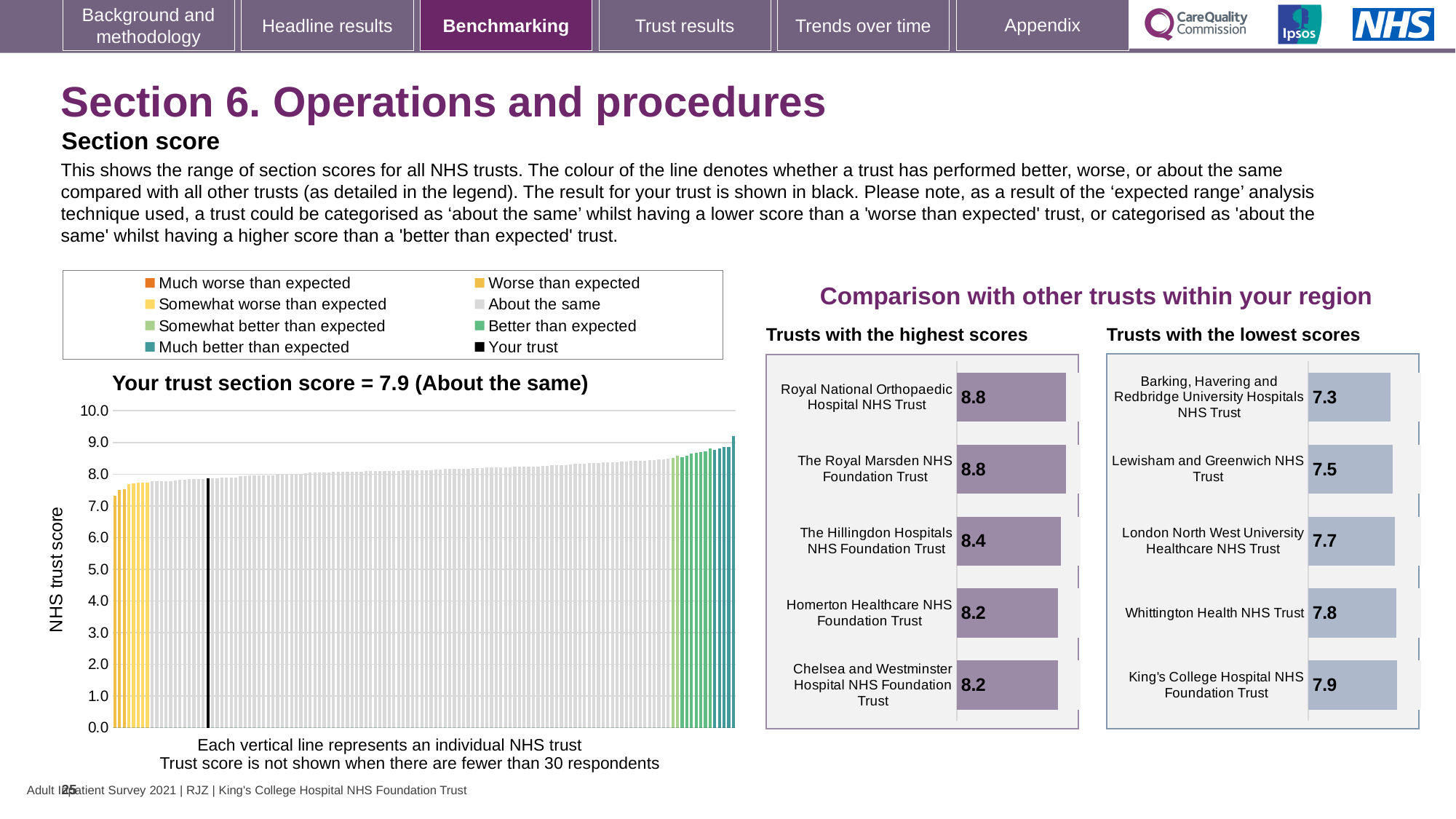
In the 'Trusts with the highest scores' chart, what is the score for The Hillingdon Hospitals NHS Foundation Trust? 8.4 Which is larger: the score for The Hillingdon Hospitals NHS Foundation Trust in the 'Trusts with the highest scores' chart or the score for Lewisham and Greenwich NHS Trust in the 'Trusts with the lowest scores' chart? The Hillingdon Hospitals NHS Foundation Trust In the 'Trusts with the lowest scores' chart, which trust has the lowest score? Barking, Havering and Redbridge University Hospitals NHS Trust In the 'Your trust section score' chart, is the value of the lowest bar greater or less than 8.0? less In the 'Trusts with the highest scores' chart, what is the score for Homerton Healthcare NHS Foundation Trust? 8.2 In the 'Trusts with the lowest scores' chart, which trust has the highest score? King's College Hospital NHS Foundation Trust In the 'Trusts with the highest scores' chart, what is the difference between the score for Royal National Orthopaedic Hospital NHS Trust and the score for Chelsea and Westminster Hospital NHS Foundation Trust? 0.6 How many trusts are shown in the 'Trusts with the highest scores' chart? 5 What is the y-axis label of the 'Your trust section score' chart? NHS trust score How many entries does the legend above the 'Your trust section score' chart list? 8 In the chart 'Your trust section score', what is the section score for your trust? 7.9 What kind of chart is 'Your trust section score = 7.9 (About the same)'? bar chart